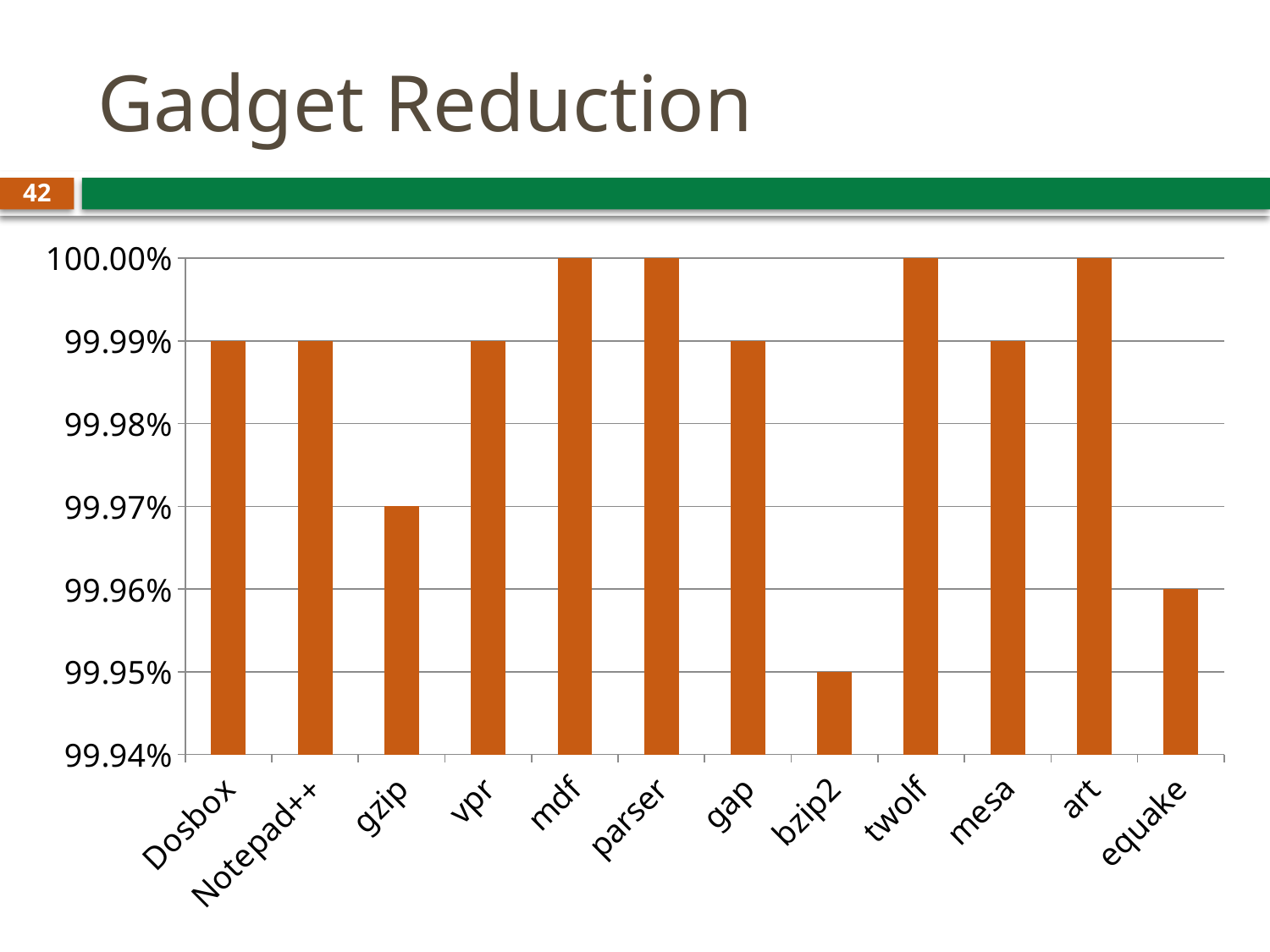
What kind of chart is shown on the slide? bar chart What is the value for mdf? 100.00% Which category has the lowest value? bzip2 What is the value for equake? 99.96% What is the value for bzip2? 99.95% Which is larger, the value for gzip or the value for equake? gzip How many categories are shown on the x axis? 12 Is the value for equake greater or less than 99.97%? less What is the title of the slide containing the chart? Gadget Reduction What is the difference between the values for gzip and bzip2? 0.02% Is the value for Dosbox greater or less than 99.98%? greater What is the value for gzip? 99.97%